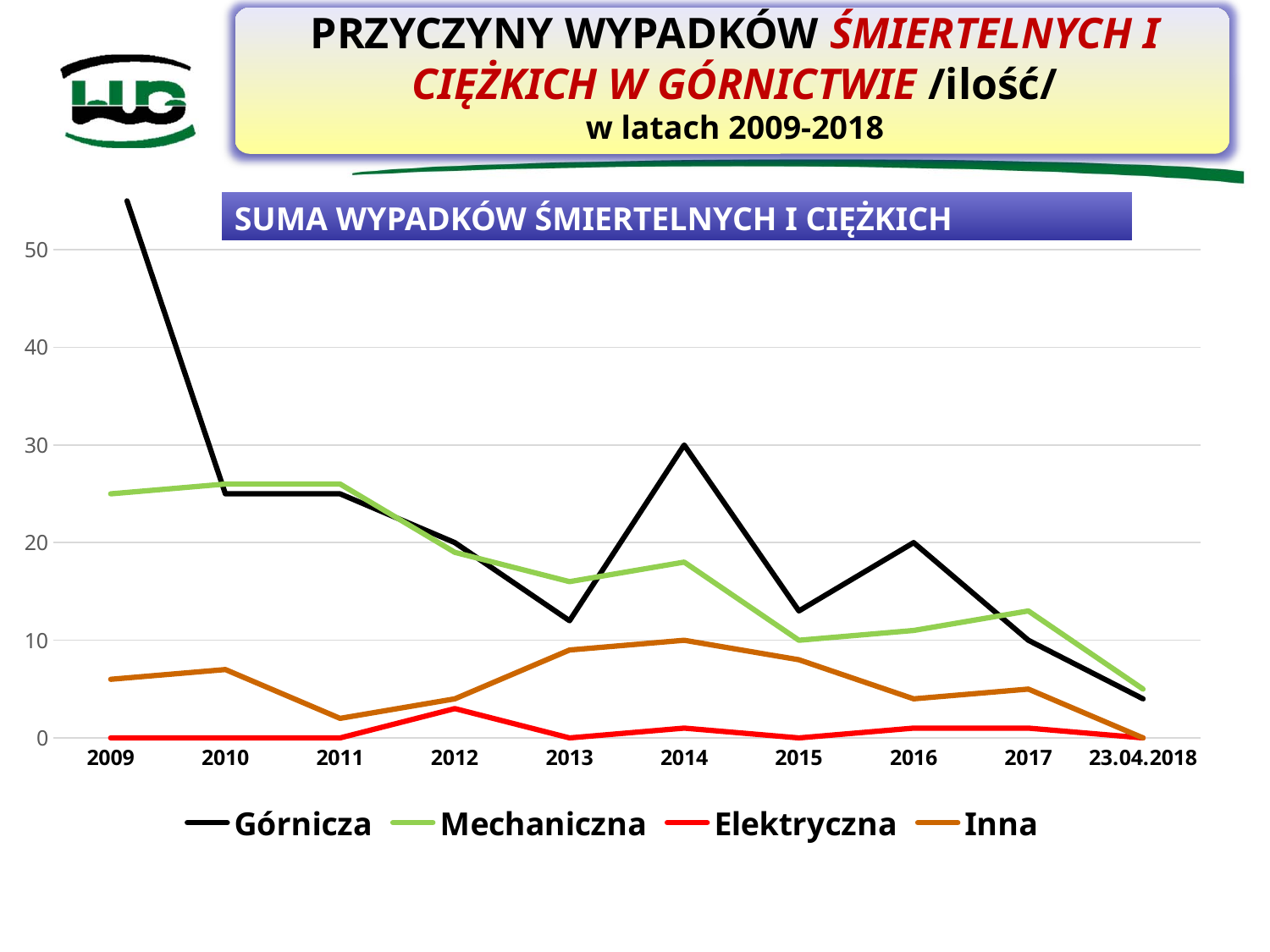
Does the Mechaniczna series overall rise or fall from 2009 to 23.04.2018? fall What is the value for Inna at 23.04.2018? 0 Is the value for Mechaniczna in 2009 greater or less than 20? greater How many points (years) are shown along the x axis? 10 In 2014, which series is larger: Górnicza or Mechaniczna? Górnicza In which year is the Górnicza series at its highest? 2009 How many series does the legend list? 4 What kind of chart is shown on the slide? line chart At which x-axis point is the Górnicza series at its lowest? 23.04.2018 Is the value for Górnicza in 2009 greater or less than 50? greater What is the value for Elektryczna in 2009? 0